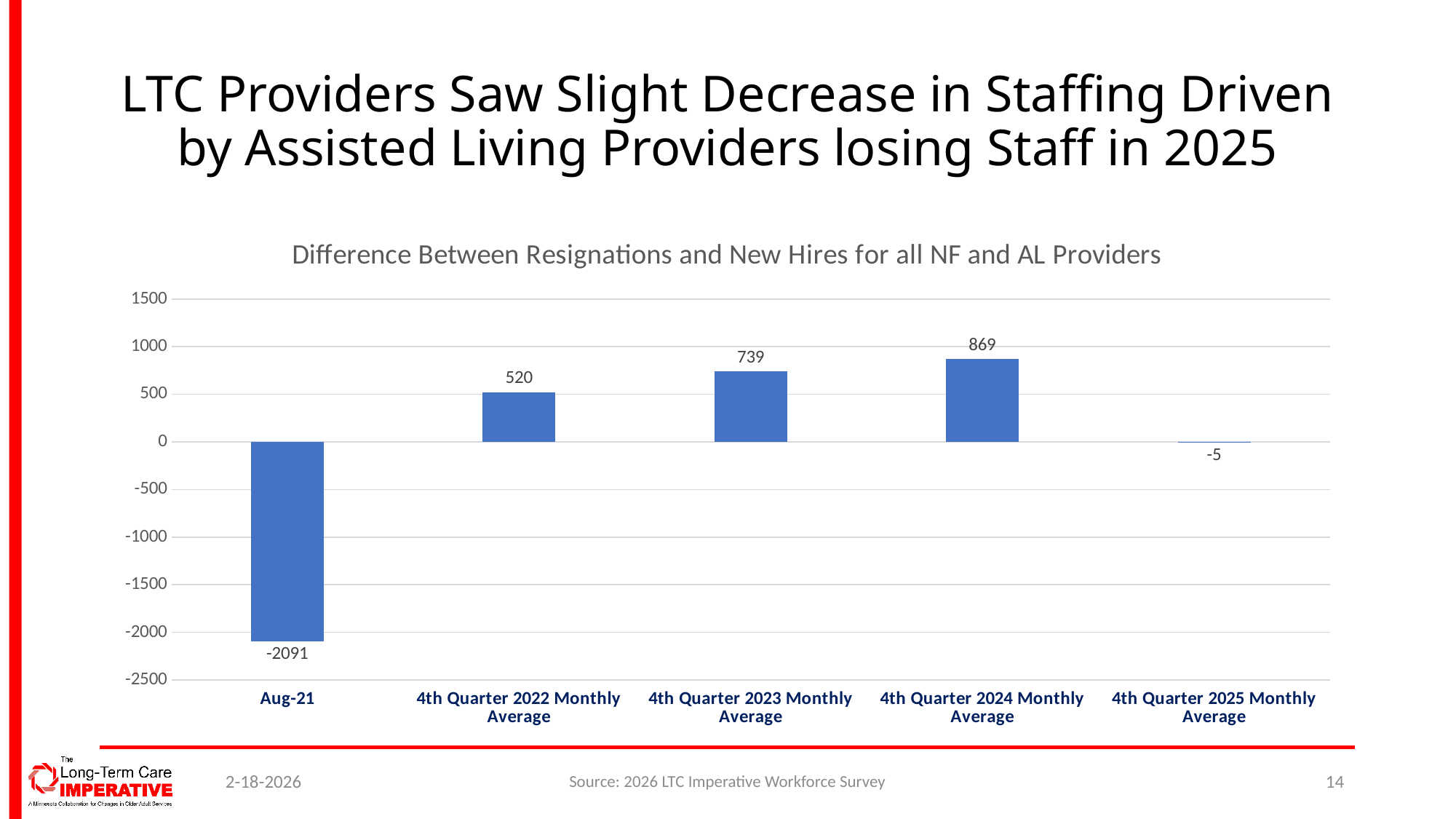
Do the values rise or fall from the 4th Quarter 2022 Monthly Average to the 4th Quarter 2024 Monthly Average? Rise What is the value for the 4th Quarter 2025 Monthly Average? -5 What is the difference between the 4th Quarter 2024 Monthly Average and the 4th Quarter 2023 Monthly Average? 130 How many categories are shown on the x axis? 5 What is the value for the 4th Quarter 2022 Monthly Average? 520 What is the title of the chart? Difference Between Resignations and New Hires for all NF and AL Providers Which category has the highest value? 4th Quarter 2024 Monthly Average Which is larger, the value for the 4th Quarter 2023 Monthly Average or the 4th Quarter 2022 Monthly Average? 4th Quarter 2023 Monthly Average What kind of chart is shown on the slide? Bar chart What is the value for the 4th Quarter 2024 Monthly Average? 869 What is the value for Aug-21? -2091 Which category has the lowest value? Aug-21